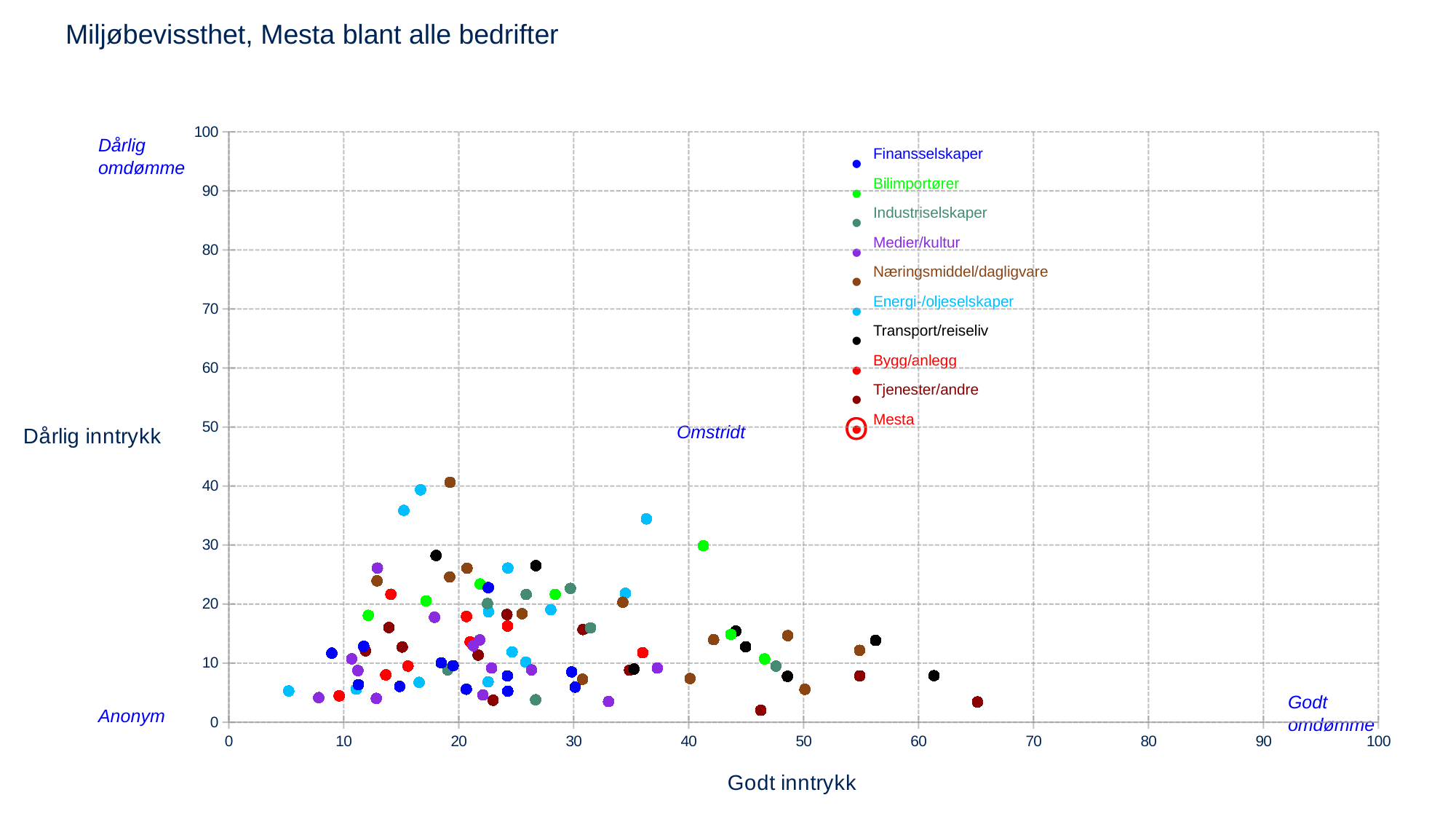
What is the title of the chart? Miljøbevissthet, Mesta blant alle bedrifter What kind of chart is shown on the slide? scatter chart How many entries does the legend list? 10 What is the label of the horizontal axis? Godt inntrykk Is the vertical value of the highest plotted point greater or less than 30? greater What is the highest value shown on the vertical axis? 100 What is the highest value shown on the horizontal axis? 100 Is the vertical value of the highest plotted point greater or less than 50? less Which legend entry is shown with a red ring marker instead of a filled dot? Mesta Is the horizontal value of the rightmost plotted point greater or less than 60? greater